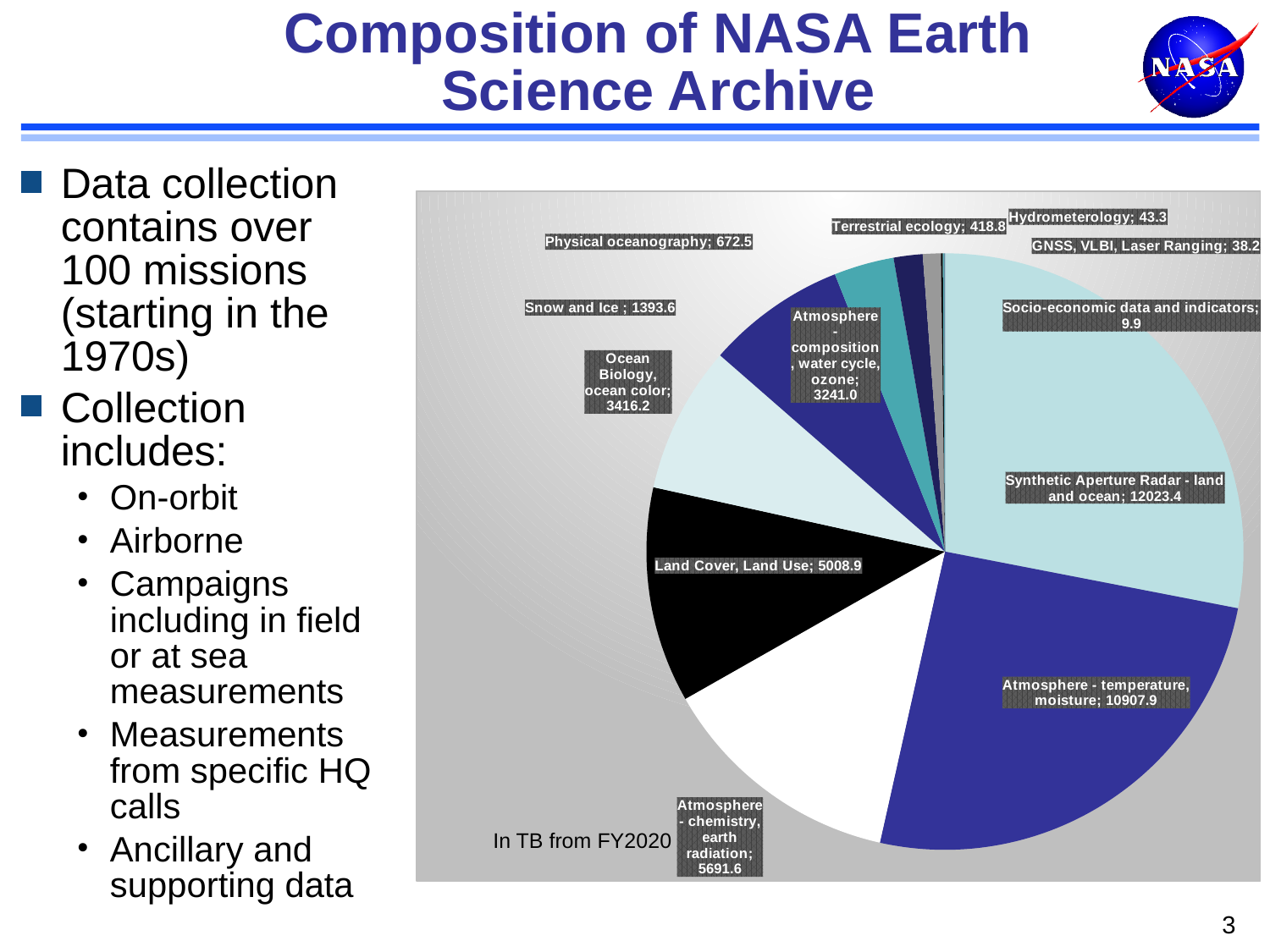
Which category has the largest value in the pie chart? Synthetic Aperture Radar - land and ocean What is the difference between Synthetic Aperture Radar - land and ocean and Atmosphere - temperature, moisture? 1115.5 Which category has the smallest value in the pie chart? Socio-economic data and indicators How many categories are shown in the pie chart? 12 What is the value for Synthetic Aperture Radar - land and ocean? 12023.4 What is the difference between Atmosphere - chemistry, earth radiation and Land Cover, Land Use? 682.7 In what unit are the values in the pie chart given? TB (from FY2020) What is the value for Snow and Ice? 1393.6 What is the value for Land Cover, Land Use? 5008.9 What is the value for Hydrometerology? 43.3 Which is larger: Ocean Biology, ocean color or Atmosphere - composition, water cycle, ozone? Ocean Biology, ocean color What type of chart is shown on the slide? pie chart